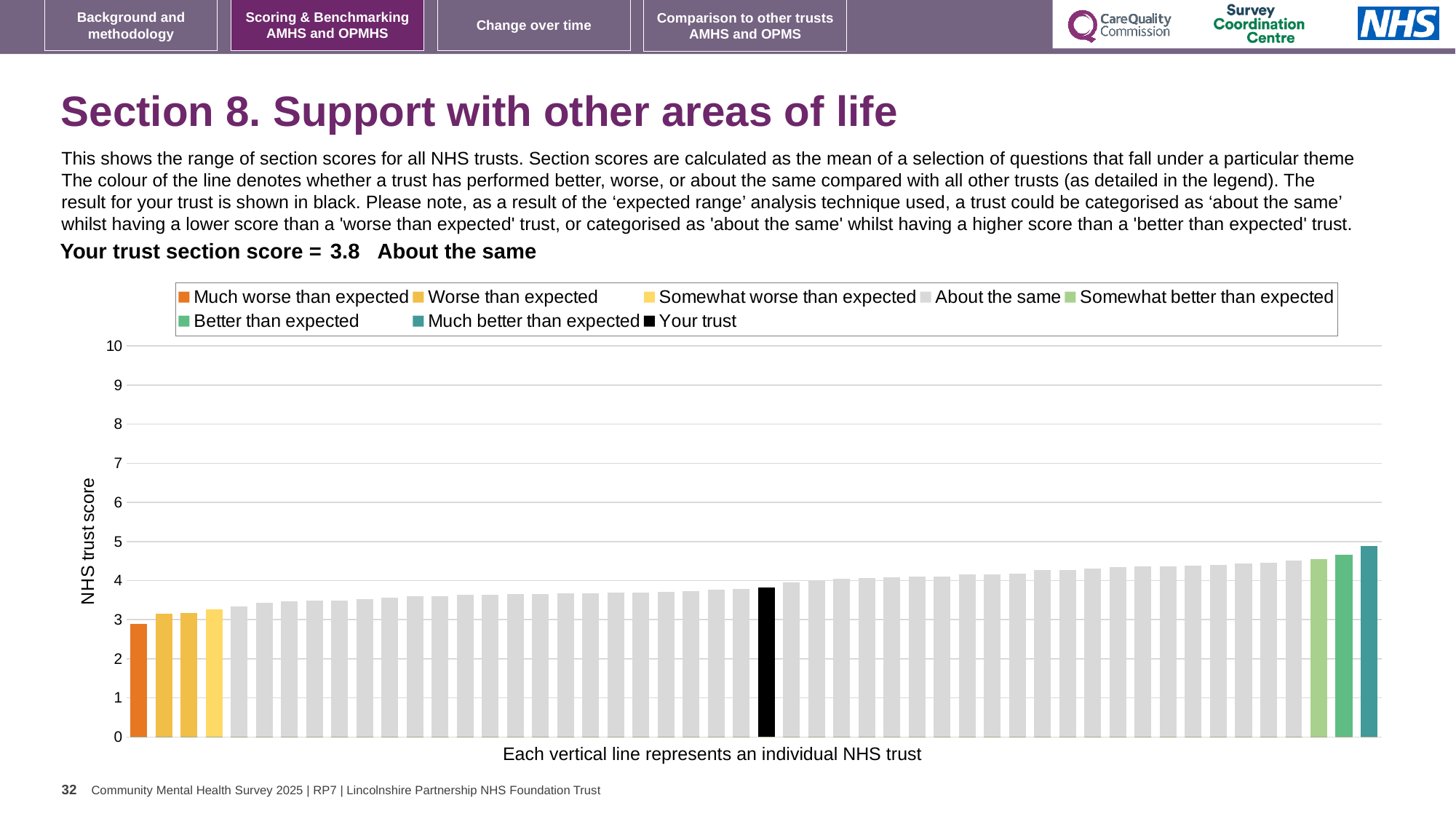
What is the label on the vertical axis of the chart? NHS trust score Is the value of the tallest bar greater or less than 4? greater How many entries does the chart legend list? 8 What kind of chart is shown on the slide? bar chart Which legend category does the tallest bar belong to? Much better than expected Is the value of the shortest bar greater or less than 2? greater Is the value for your trust (the black bar) greater or less than 3? greater Which legend category is your trust placed in? About the same What colour is used for the 'Your trust' bar in the chart? black What is the section score for your trust? 3.8 Which legend category does the shortest bar belong to? Much worse than expected Do the bar values rise or fall from left to right along the x axis? rise